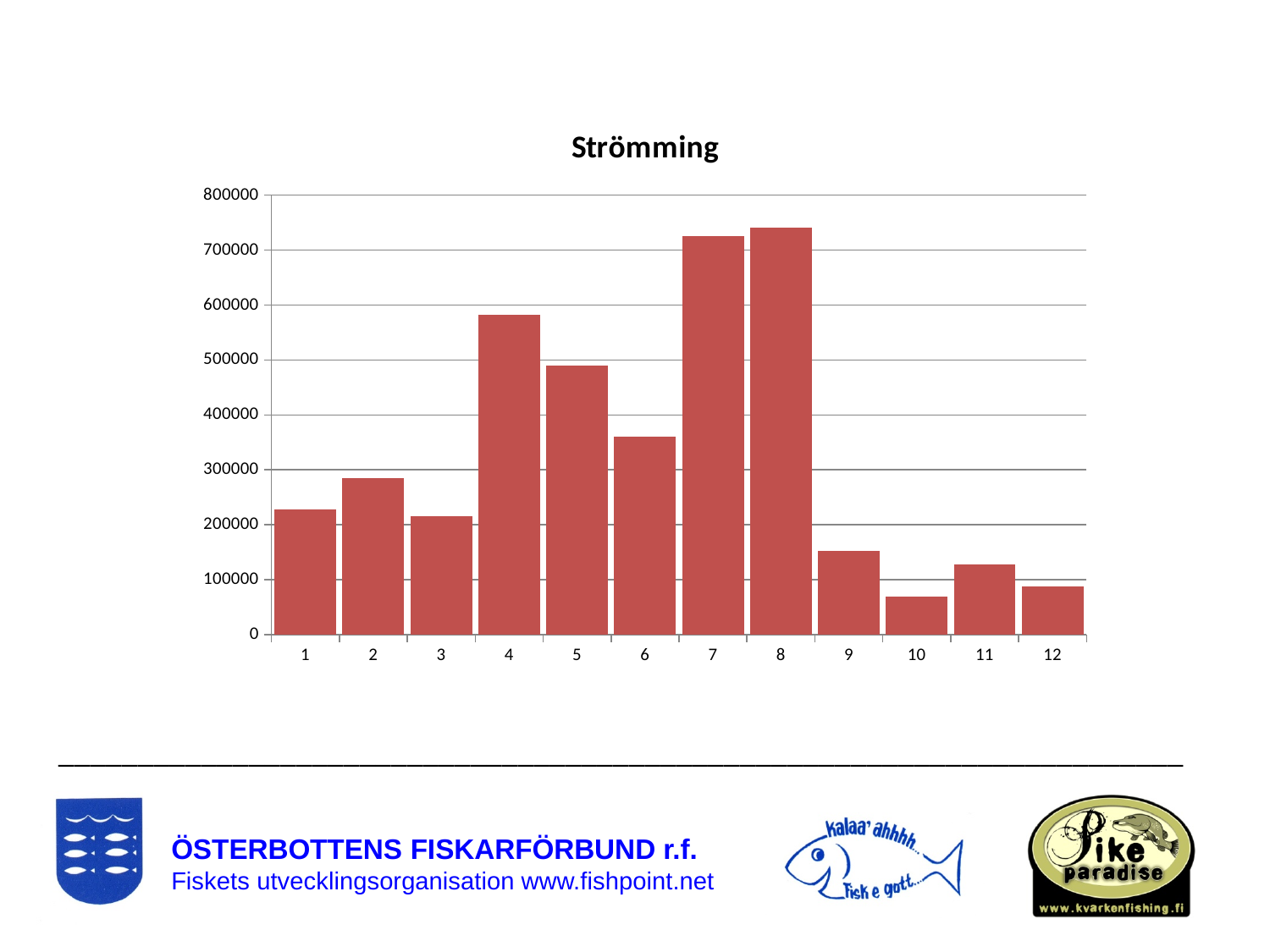
What kind of chart is shown on the slide? bar chart Which category has the lowest value in the Strömming chart? 10 Is the value for category 9 greater or less than 200000? less Is the value for category 4 greater or less than 500000? greater Do the values rise or fall from category 4 to category 6? fall Which category has the highest value in the Strömming chart? 8 How many categories are shown on the x axis of the Strömming chart? 12 Is the value for category 7 greater or less than 700000? greater Which has the larger value, category 11 or category 12? 11 Which has the larger value, category 4 or category 5? 4 What is the title of the chart? Strömming